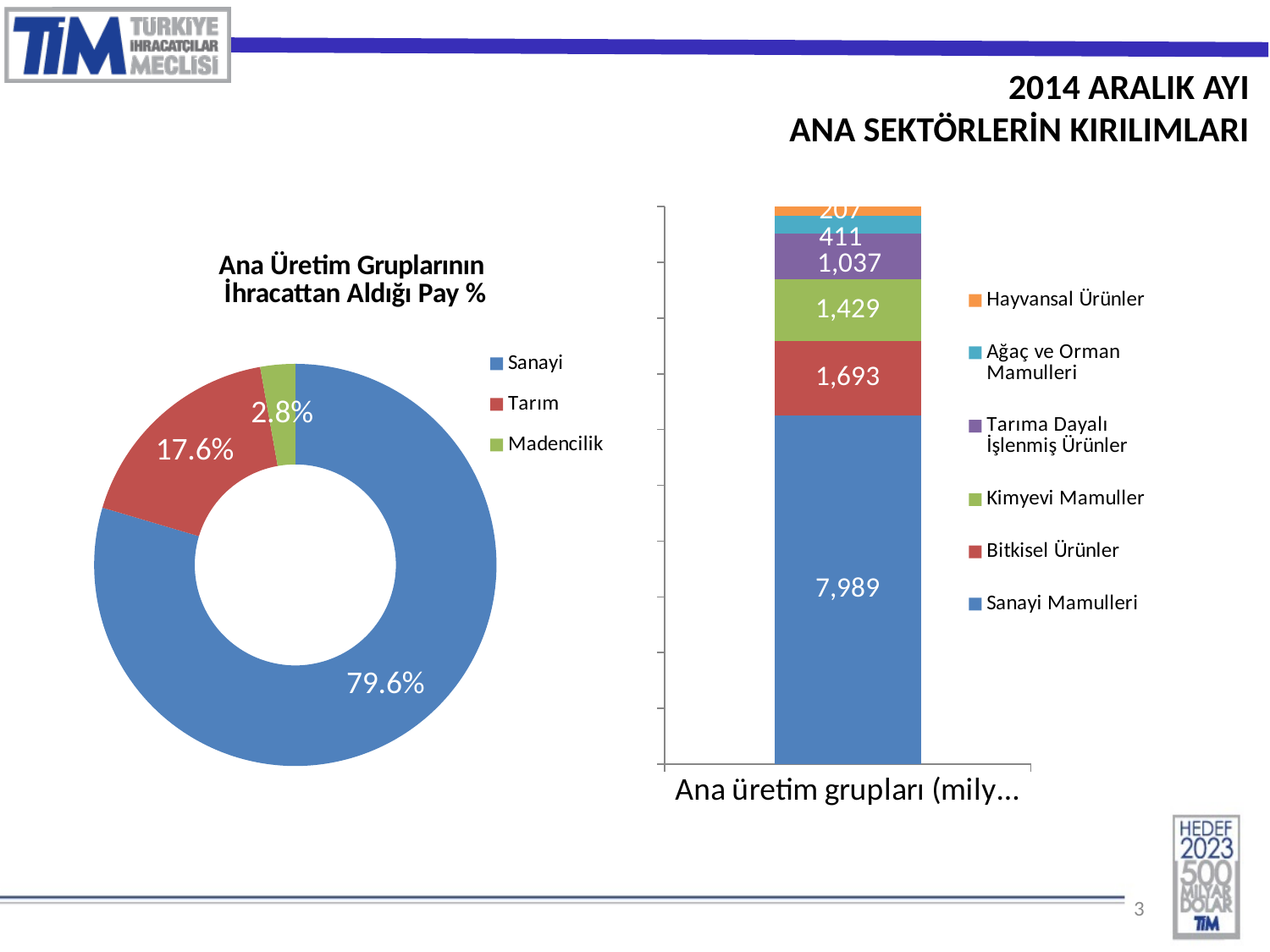
In the stacked bar chart on the right, how many series does the legend list? 6 In the stacked bar chart on the right, what is the value for Bitkisel Ürünler? 1,693 In the doughnut chart 'Ana Üretim Gruplarının İhracattan Aldığı Pay %', what share does Tarım have? 17.6% In the doughnut chart 'Ana Üretim Gruplarının İhracattan Aldığı Pay %', which group has the smallest share? Madencilik In the doughnut chart 'Ana Üretim Gruplarının İhracattan Aldığı Pay %', what share does Sanayi have? 79.6% In the doughnut chart 'Ana Üretim Gruplarının İhracattan Aldığı Pay %', how many groups are shown? 3 In the doughnut chart 'Ana Üretim Gruplarının İhracattan Aldığı Pay %', what share does Madencilik have? 2.8% In the doughnut chart 'Ana Üretim Gruplarının İhracattan Aldığı Pay %', which group has the largest share? Sanayi In the stacked bar chart on the right, what is the value for Sanayi Mamulleri? 7,989 In the doughnut chart 'Ana Üretim Gruplarının İhracattan Aldığı Pay %', by how many percentage points does Sanayi exceed Tarım? 62.0 percentage points In the stacked bar chart on the right, what is the value for Kimyevi Mamuller? 1,429 In the stacked bar chart on the right, what is the difference between Bitkisel Ürünler and Kimyevi Mamuller? 264